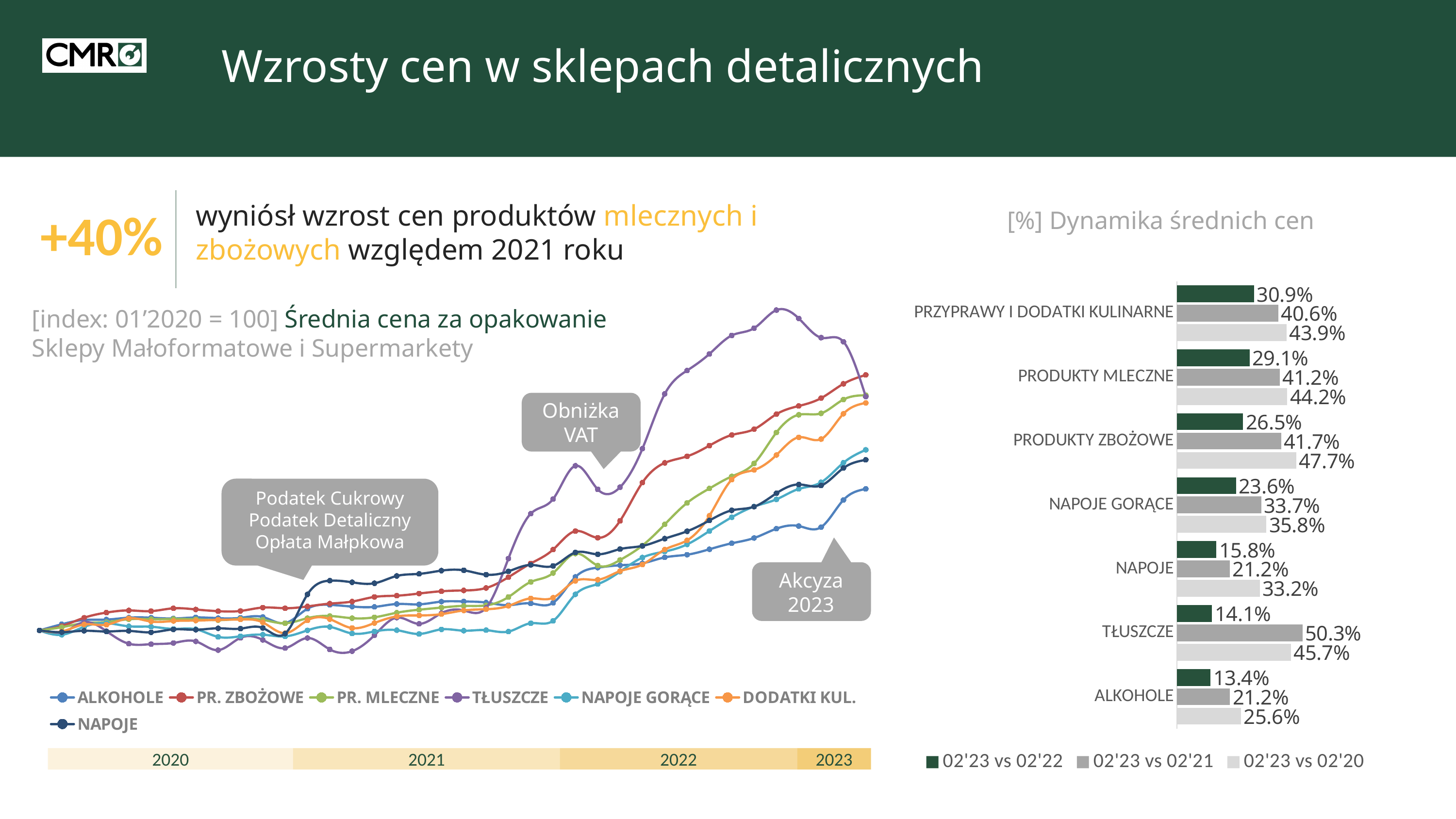
How many categories are shown in the bar chart '[%] Dynamika średnich cen'? 7 In the line chart 'Średnia cena za opakowanie', does the TŁUSZCZE series rise or fall overall from 2020 to 2023? rise In the bar chart '[%] Dynamika średnich cen', what is the 02'23 vs 02'22 value for PRODUKTY MLECZNE? 29.1% In the bar chart '[%] Dynamika średnich cen', what is the difference between the 02'23 vs 02'20 and 02'23 vs 02'22 values for NAPOJE? 17.4% How many series does the legend of the line chart 'Średnia cena za opakowanie' list? 7 In the bar chart '[%] Dynamika średnich cen', what is the 02'23 vs 02'21 value for TŁUSZCZE? 50.3% In the bar chart '[%] Dynamika średnich cen', which category has the lowest 02'23 vs 02'22 value? ALKOHOLE How many series does the legend of the bar chart '[%] Dynamika średnich cen' list? 3 In the bar chart '[%] Dynamika średnich cen', what is the 02'23 vs 02'20 value for PRODUKTY ZBOŻOWE? 47.7% What kind of chart is the chart on the left titled 'Średnia cena za opakowanie'? line chart In the bar chart '[%] Dynamika średnich cen', which category has the highest 02'23 vs 02'22 value? PRZYPRAWY I DODATKI KULINARNE In the bar chart '[%] Dynamika średnich cen', which is larger for TŁUSZCZE: the 02'23 vs 02'21 value or the 02'23 vs 02'20 value? 02'23 vs 02'21